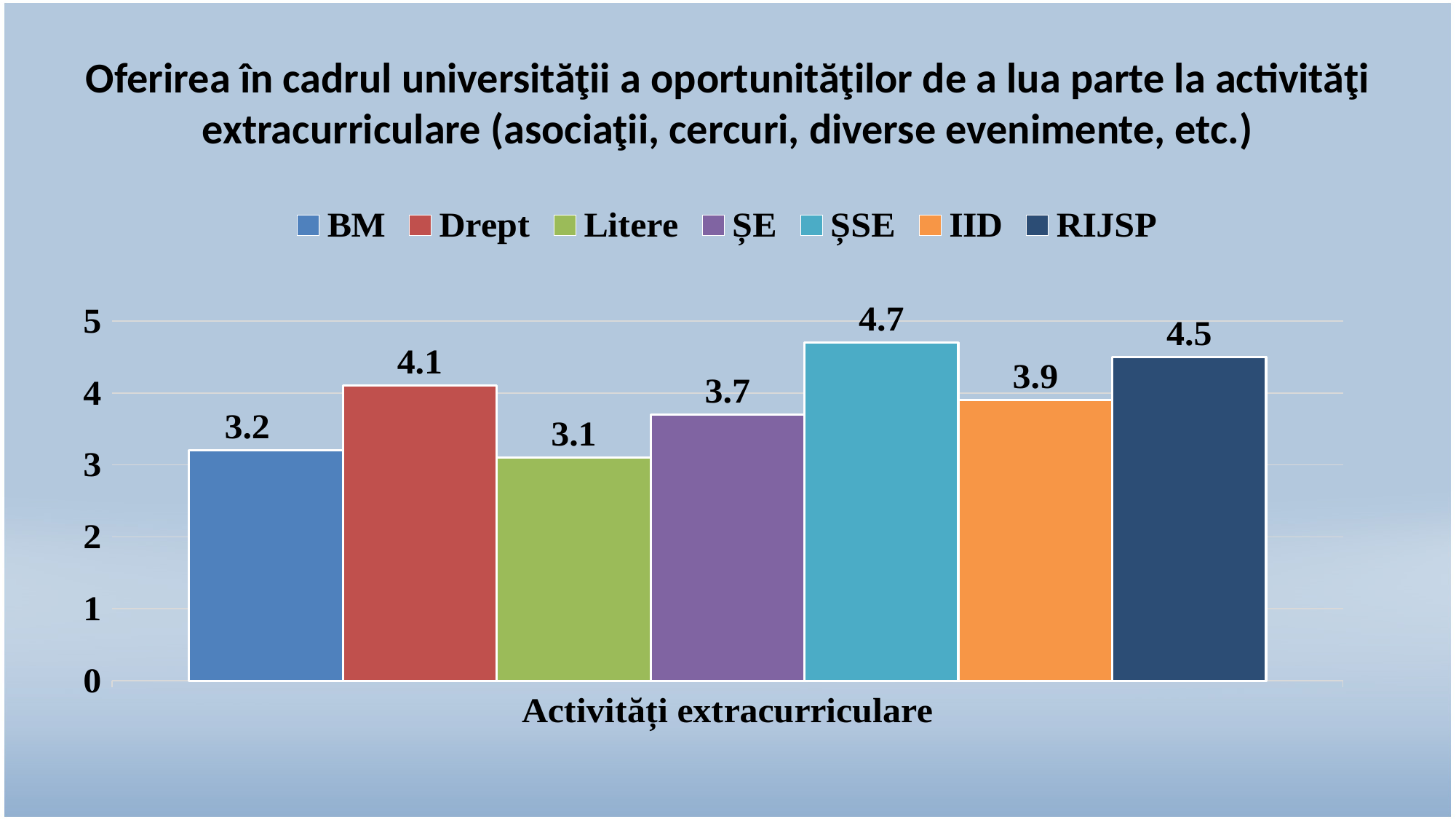
What is the value for Drept? 4.1 What is the value for IID? 3.9 Is the value for ȘE greater or less than 4? less What is the label on the x axis of the chart? Activități extracurriculare What is the value for ȘSE? 4.7 What kind of chart is shown on the slide? bar chart How many series does the legend list? 7 What is the difference between the values for RIJSP and BM? 1.3 Which series has the lowest value? Litere What is the difference between the values for ȘSE and ȘE? 1 Which series has the highest value? ȘSE Which is larger, the value for Drept or the value for IID? Drept